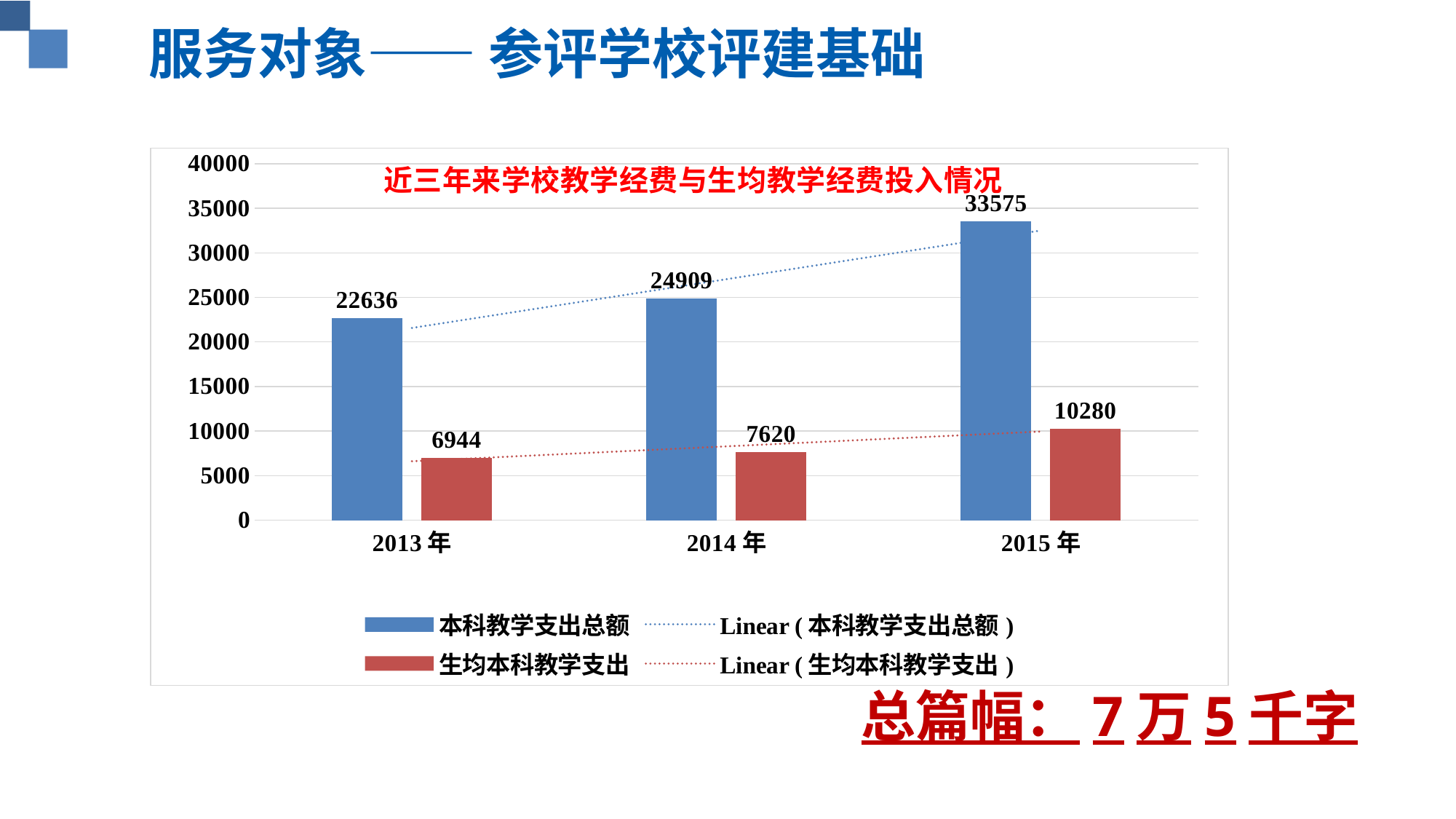
How many years are shown on the x axis? 3 What is the title of the chart? 近三年来学校教学经费与生均教学经费投入情况 What is the value of 生均本科教学支出 for 2014 年? 7620 Which is larger: 生均本科教学支出 for 2014 年 or for 2013 年? 2014 年 What is the difference between the 本科教学支出总额 values for 2015 年 and 2014 年? 8666 What is the value of 生均本科教学支出 for 2015 年? 10280 Which year has the highest value for 本科教学支出总额? 2015 年 What kind of chart is shown on the slide? Bar chart Which year has the lowest value for 生均本科教学支出? 2013 年 Do the values for 本科教学支出总额 rise or fall from 2013 年 to 2015 年? Rise How many entries does the legend list? 4 What is the value of 本科教学支出总额 for 2013 年? 22636